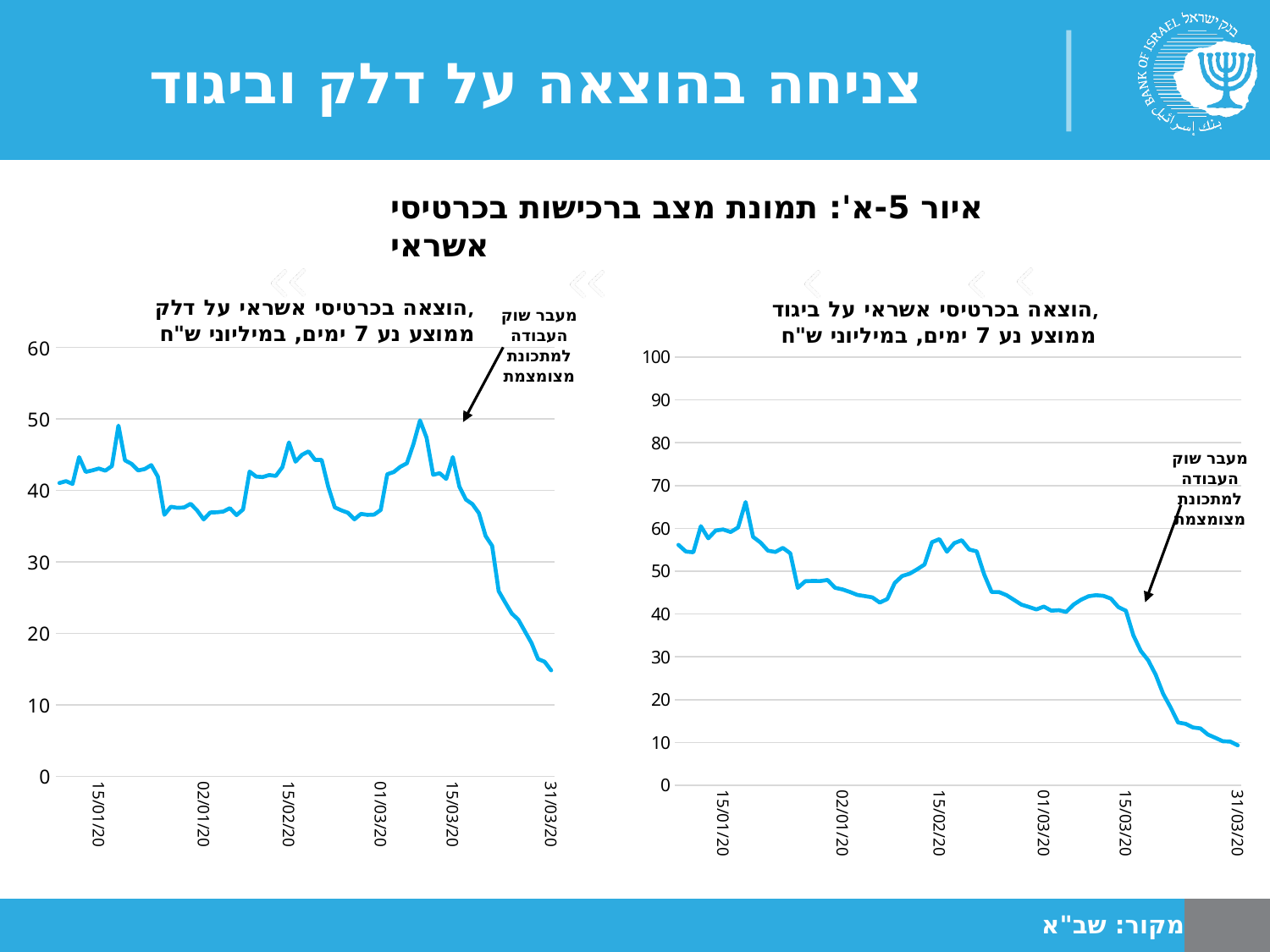
In the right chart (clothing spending), is the value at 15/02/20 greater or less than 50? greater In the right chart (clothing spending), does the line rise or fall between 15/03/20 and 31/03/20? fall In the right chart (clothing spending), is the highest point of the line greater or less than 60? greater In the left chart (fuel spending), is the value at 02/01/20 greater or less than 40? less What kind of chart is the right chart (הוצאה בכרטיסי אשראי על ביגוד)? line chart What event does the arrow annotation on each chart mark? מעבר שוק העבודה למתכונת מצומצמת In the left chart (fuel spending), does the line rise or fall between 15/03/20 and 31/03/20? fall What kind of chart is the left chart (הוצאה בכרטיסי אשראי על דלק)? line chart How many charts are shown on the slide? 2 What is the overall figure title shown above the two charts? איור 5-א': תמונת מצב ברכישות בכרטיסי אשראי